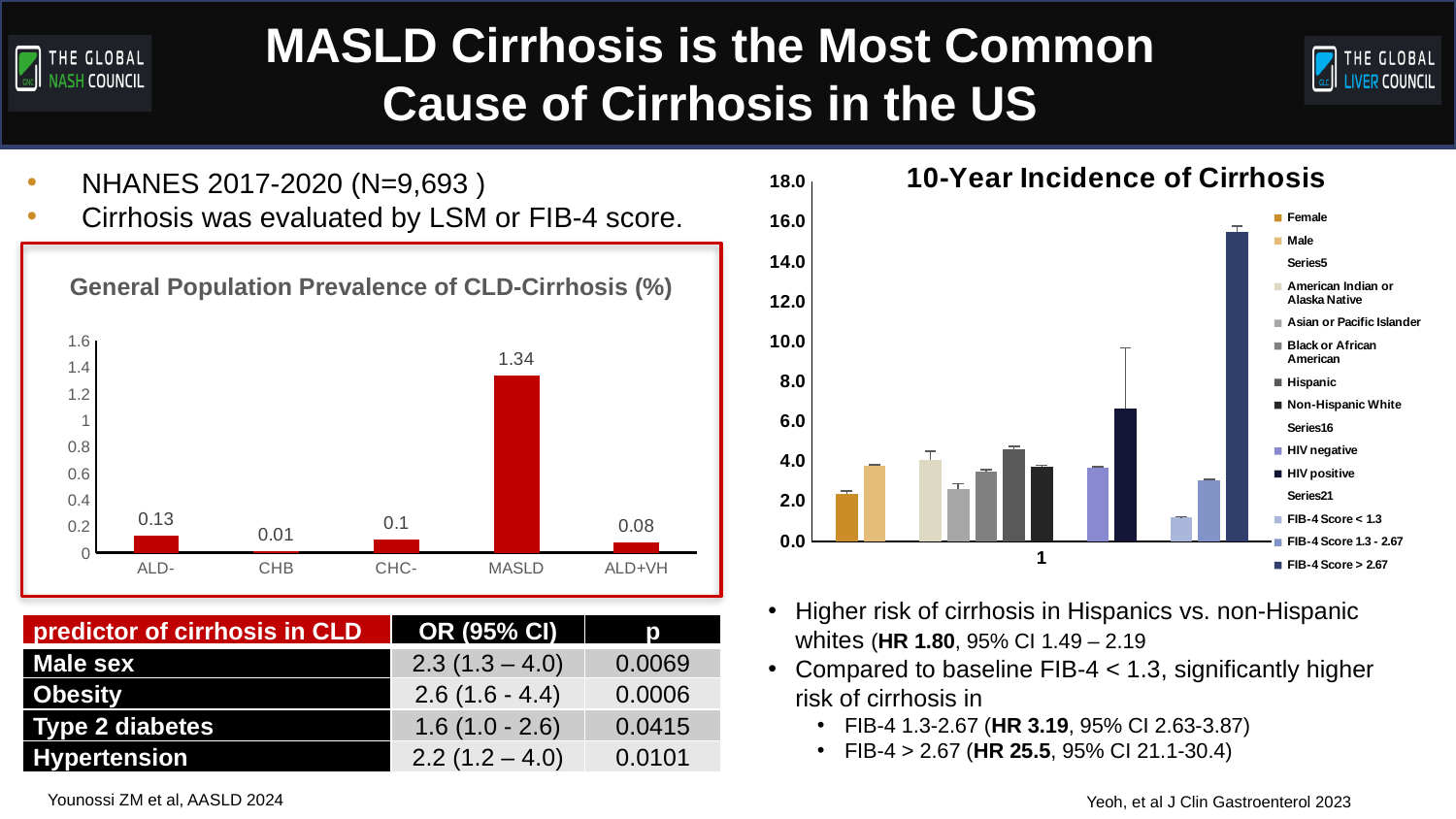
On the 'General Population Prevalence of CLD-Cirrhosis (%)' chart, which category has the lowest value? CHB What kind of chart is the '10-Year Incidence of Cirrhosis' chart? Bar chart On the 'General Population Prevalence of CLD-Cirrhosis (%)' chart, what is the difference between the MASLD value and the ALD- value? 1.21 On the '10-Year Incidence of Cirrhosis' chart, is the value for FIB-4 Score > 2.67 greater or less than 14.0? greater On the 'General Population Prevalence of CLD-Cirrhosis (%)' chart, which category has the highest value? MASLD On the 'General Population Prevalence of CLD-Cirrhosis (%)' chart, how many categories are shown on the x axis? 5 On the 'General Population Prevalence of CLD-Cirrhosis (%)' chart, what is the value for ALD+VH? 0.08 On the '10-Year Incidence of Cirrhosis' chart, which legend series has the tallest bar? FIB-4 Score > 2.67 On the '10-Year Incidence of Cirrhosis' chart, is the value for FIB-4 Score < 1.3 greater or less than 2.0? less On the 'General Population Prevalence of CLD-Cirrhosis (%)' chart, what is the value for MASLD? 1.34 On the 'General Population Prevalence of CLD-Cirrhosis (%)' chart, what is the value for CHB? 0.01 On the 'General Population Prevalence of CLD-Cirrhosis (%)' chart, which is larger, ALD- or CHC-? ALD-